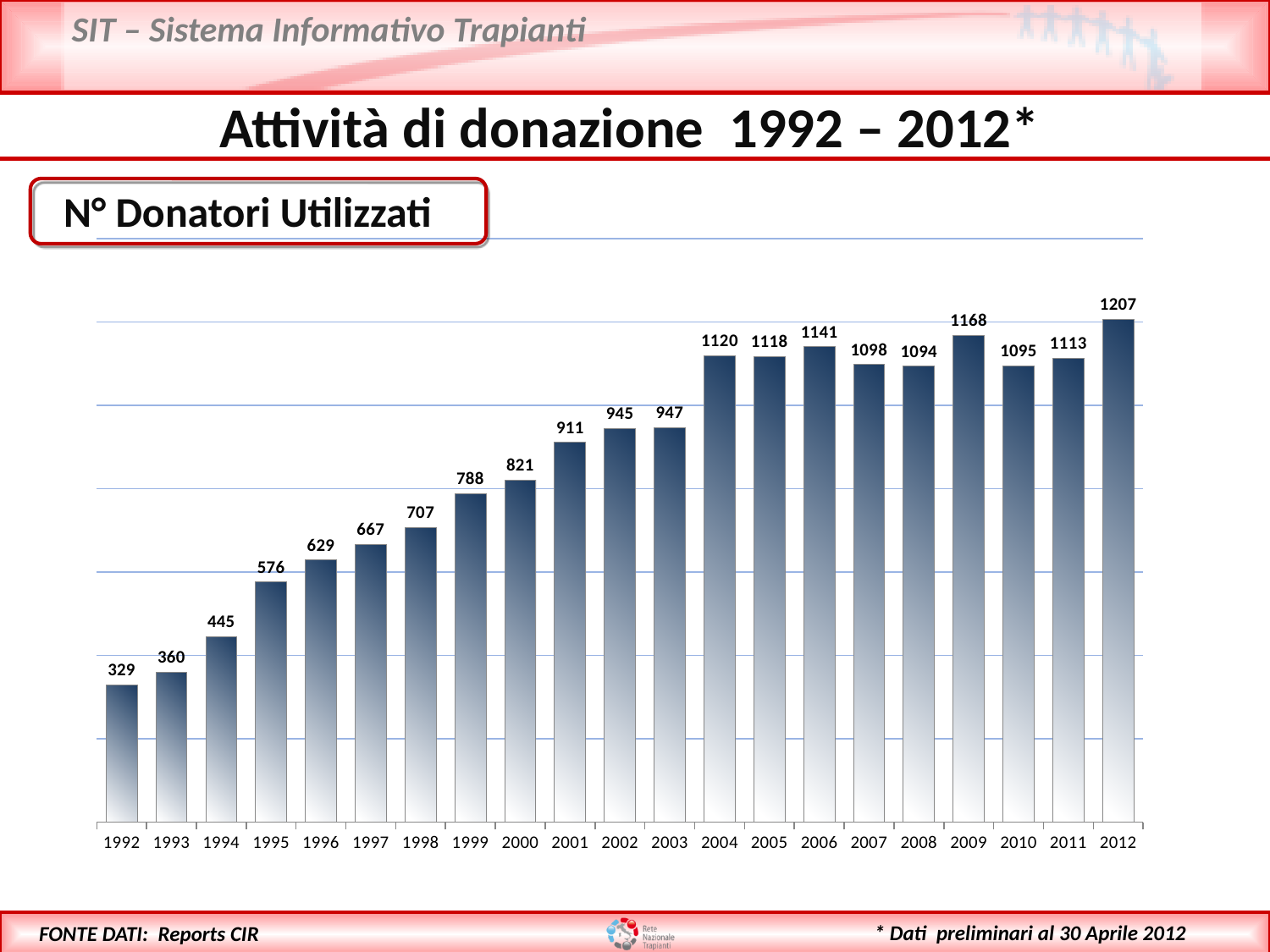
What is the difference between the values for 2003 and 2004? 173 What kind of chart is shown on the slide? Bar chart What value is shown for 1992? 329 What is the number of donors used (N° Donatori Utilizzati) in 2004? 1120 What is the title of the chart shown in the box above the bars? N° Donatori Utilizzati What value is shown for 2009? 1168 Which is larger, the value for 2006 or the value for 2007? 2006 Do the values generally rise or fall from 1992 to 2012? Rise How many years are shown on the x axis? 21 What is the difference between the values for 2012 and 1992? 878 Which year has the highest number of donors used? 2012 Which year has the lowest number of donors used? 1992